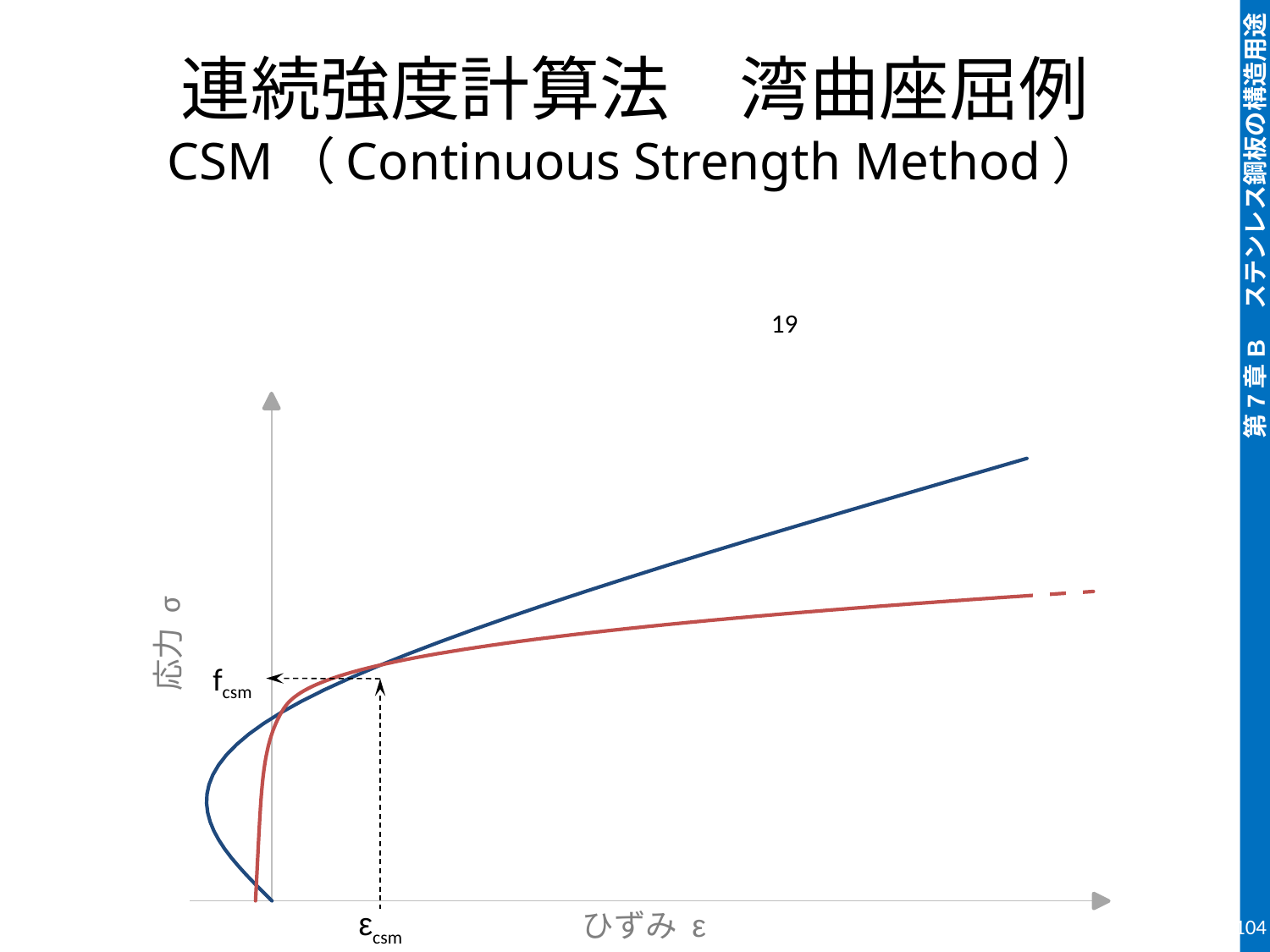
Does the blue curve rise or fall as strain increases toward the right side of the chart? rise Does the red curve rise or fall as strain increases toward the right side of the chart? rise What kind of chart is shown on the slide? line chart What is the label on the horizontal axis of the chart? ひずみ ε What is the label on the vertical axis of the chart? 応力 σ At the right-hand end of the chart, which curve is higher, the blue one or the red one? blue How many curves are plotted on the chart? 2